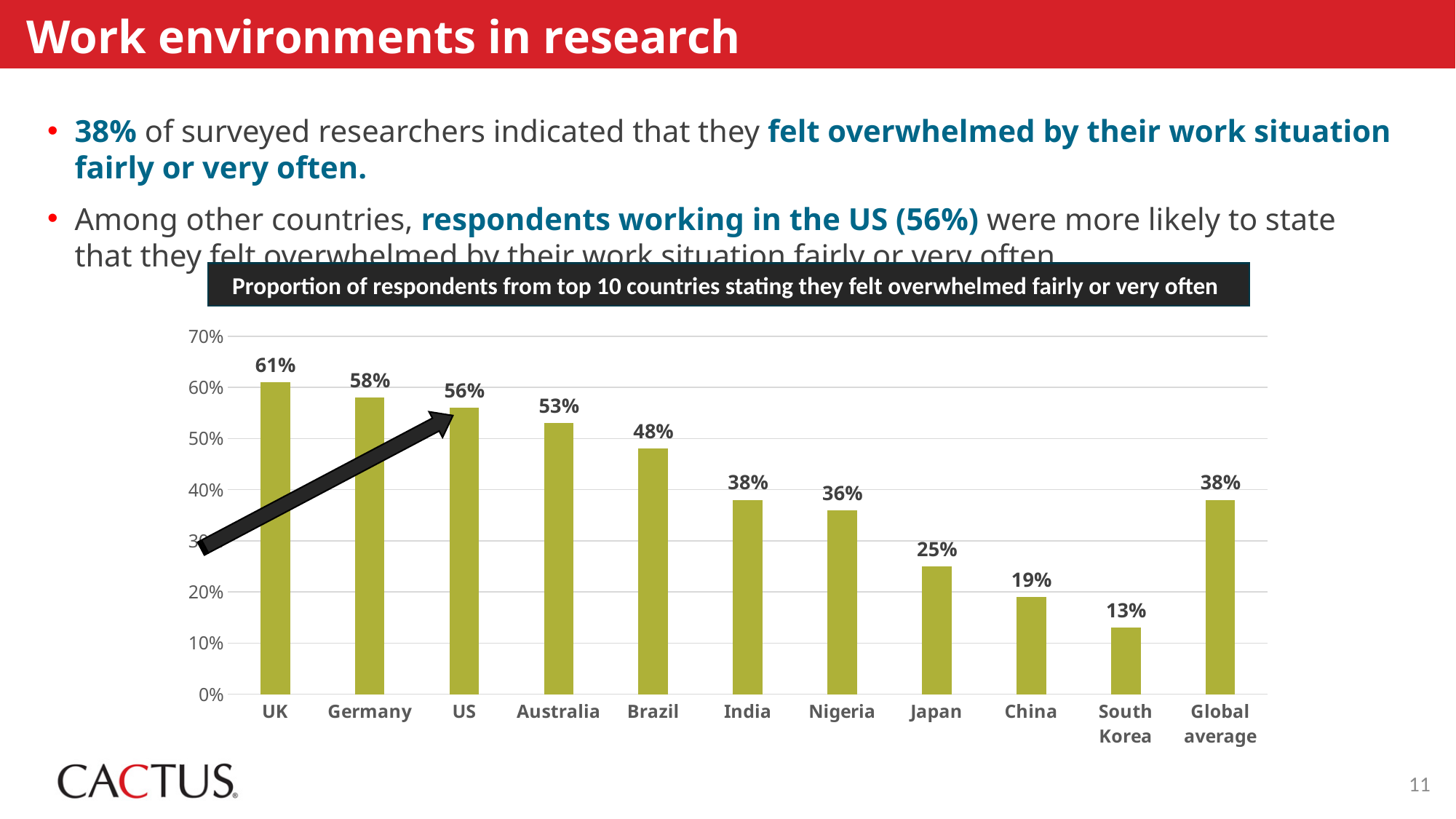
Which country has the highest proportion of respondents feeling overwhelmed fairly or very often? UK Which has a higher value, Japan or China? Japan What is the title of the chart? Proportion of respondents from top 10 countries stating they felt overwhelmed fairly or very often Do the values for the countries rise or fall from left to right across the x axis (excluding the Global average)? Fall Which country has the lowest proportion of respondents feeling overwhelmed fairly or very often? South Korea What is the value shown for South Korea? 13% What is the value shown for Brazil? 48% How many bars are shown in the chart? 11 Is the value for Nigeria greater or less than 40%? less What percentage of respondents from the UK stated they felt overwhelmed fairly or very often? 61% What is the difference between the values for the US and the Global average? 18% What kind of chart is shown on the slide? Bar chart